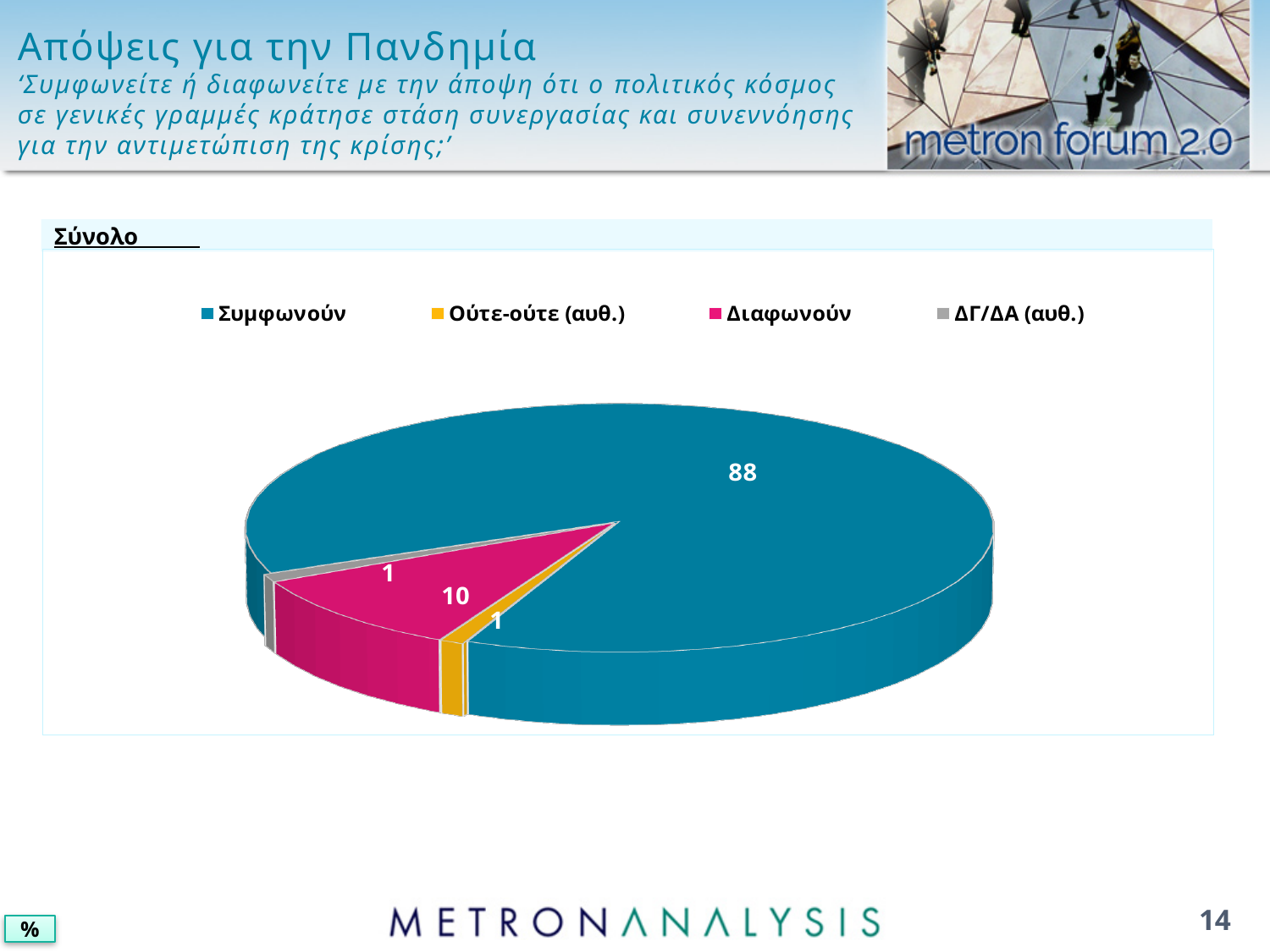
What colour is the slice for Διαφωνούν? magenta Which category has the largest slice of the pie? Συμφωνούν What kind of chart is shown on the slide? pie chart What is the heading printed above the chart? Σύνολο What is the value for Ούτε-ούτε (αυθ.)? 1 How many categories does the legend list? 4 What is the difference between the values for Συμφωνούν and Διαφωνούν? 78 Which is larger, the value for Διαφωνούν or the value for Ούτε-ούτε (αυθ.)? Διαφωνούν How many slices does the pie chart have? 4 What is the value for Διαφωνούν? 10 What is the value for ΔΓ/ΔΑ (αυθ.)? 1 What is the value for Συμφωνούν? 88